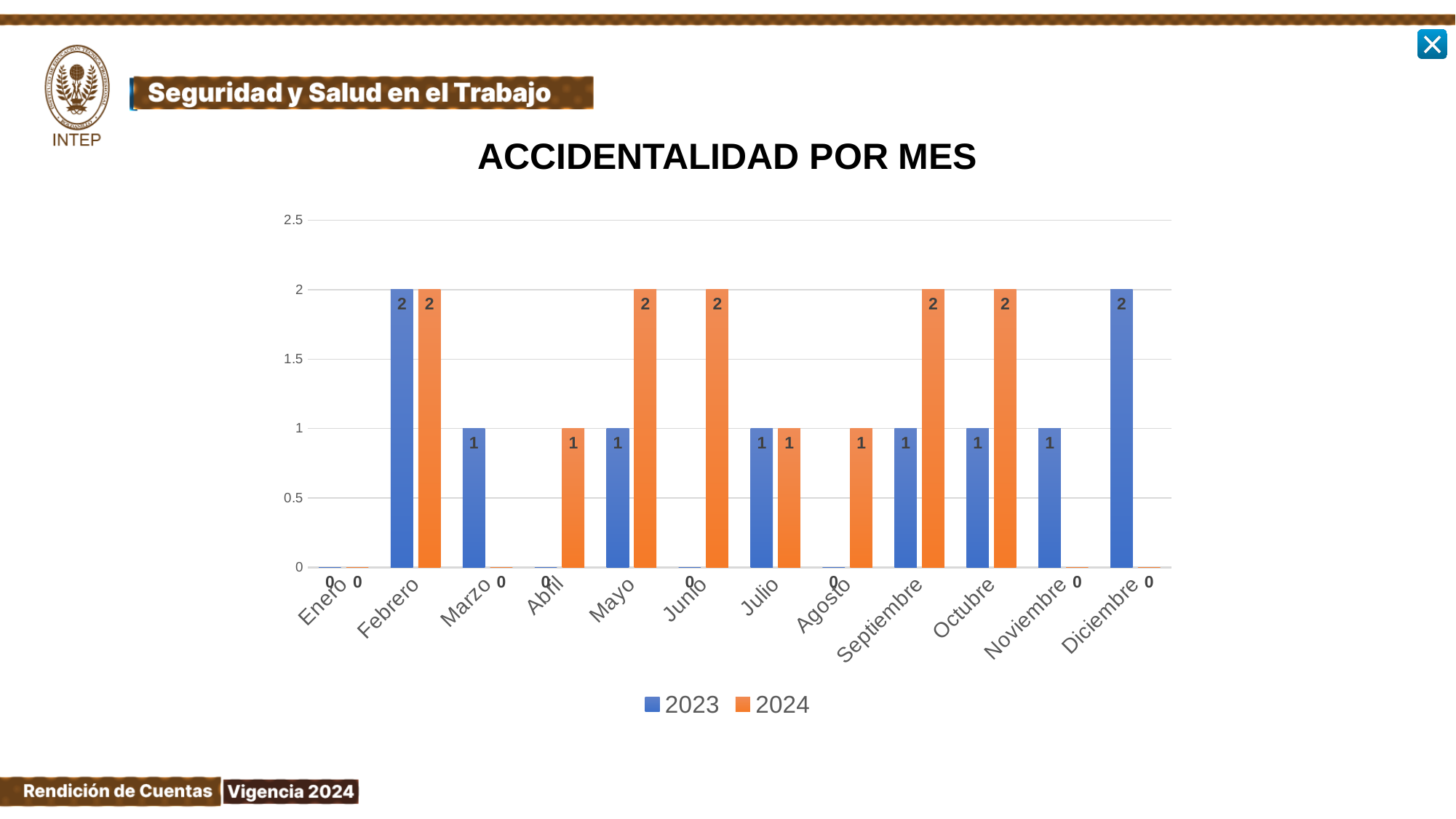
What type of chart is shown on the slide? bar chart What is the difference between the 2024 and 2023 values in Septiembre? 1 What is the value for 2023 in Abril? 0 How many months are shown on the x axis? 12 What is the title of the chart? ACCIDENTALIDAD POR MES Which series is shown in orange? 2024 What is the value for 2024 in Noviembre? 0 What is the difference between the 2023 values for Febrero and Marzo? 1 What is the value for 2024 in Junio? 2 Which is larger in Mayo, the 2023 value or the 2024 value? 2024 What is the value for 2023 in Diciembre? 2 How many series does the legend list? 2